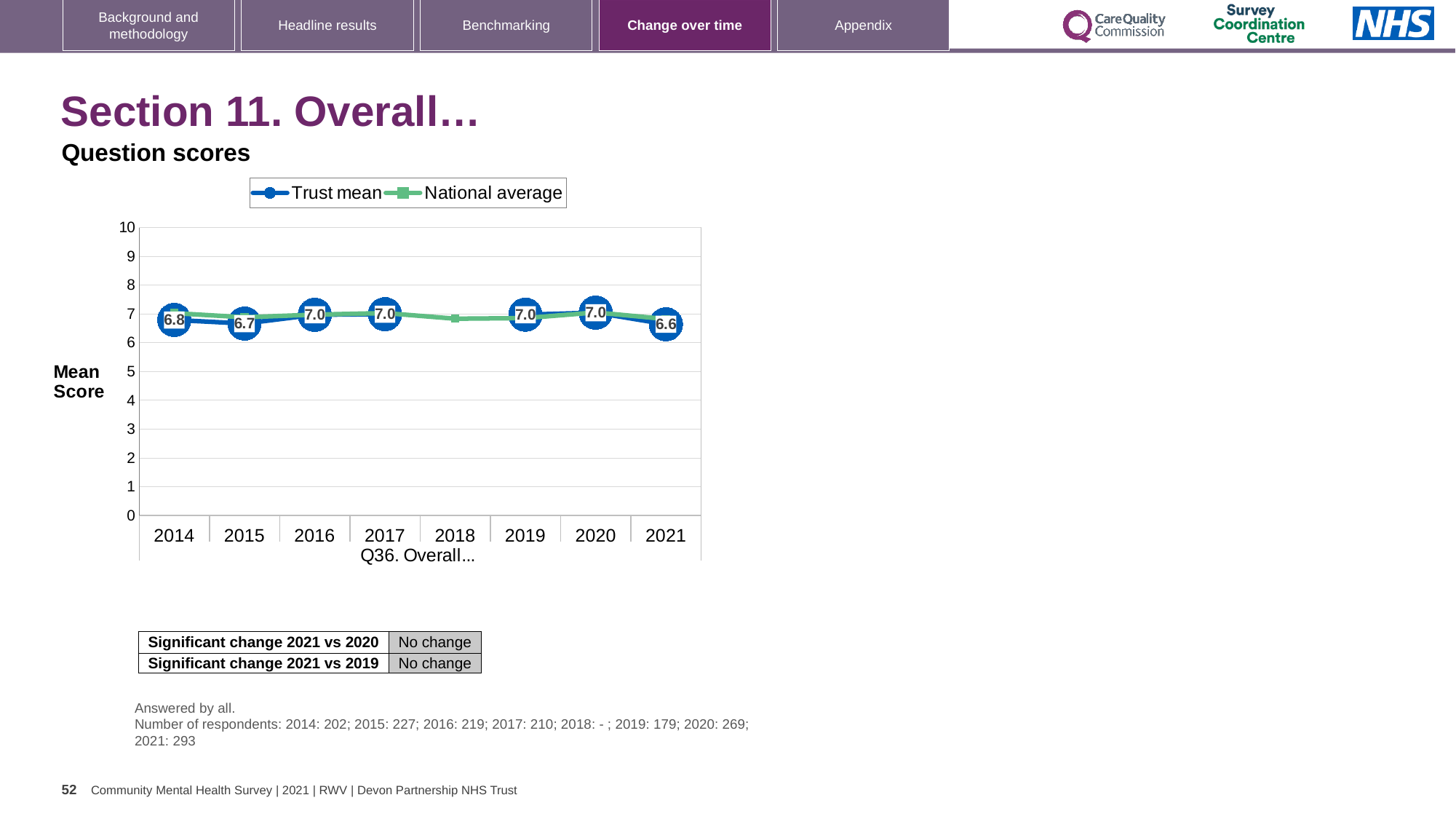
How many years are shown on the x axis? 8 What is the label on the y axis? Mean Score What is the Trust mean for 2014? 6.8 What is the Trust mean for 2021? 6.6 What is the Trust mean for 2015? 6.7 Which is larger, the Trust mean for 2016 or for 2021? 2016 Does the Trust mean rise or fall from 2020 to 2021? Fall What is the difference between the Trust mean in 2014 and in 2021? 0.2 How many series does the legend list? 2 What is the Trust mean for 2019? 7.0 What kind of chart is shown? Line chart Which year has the lowest Trust mean? 2021